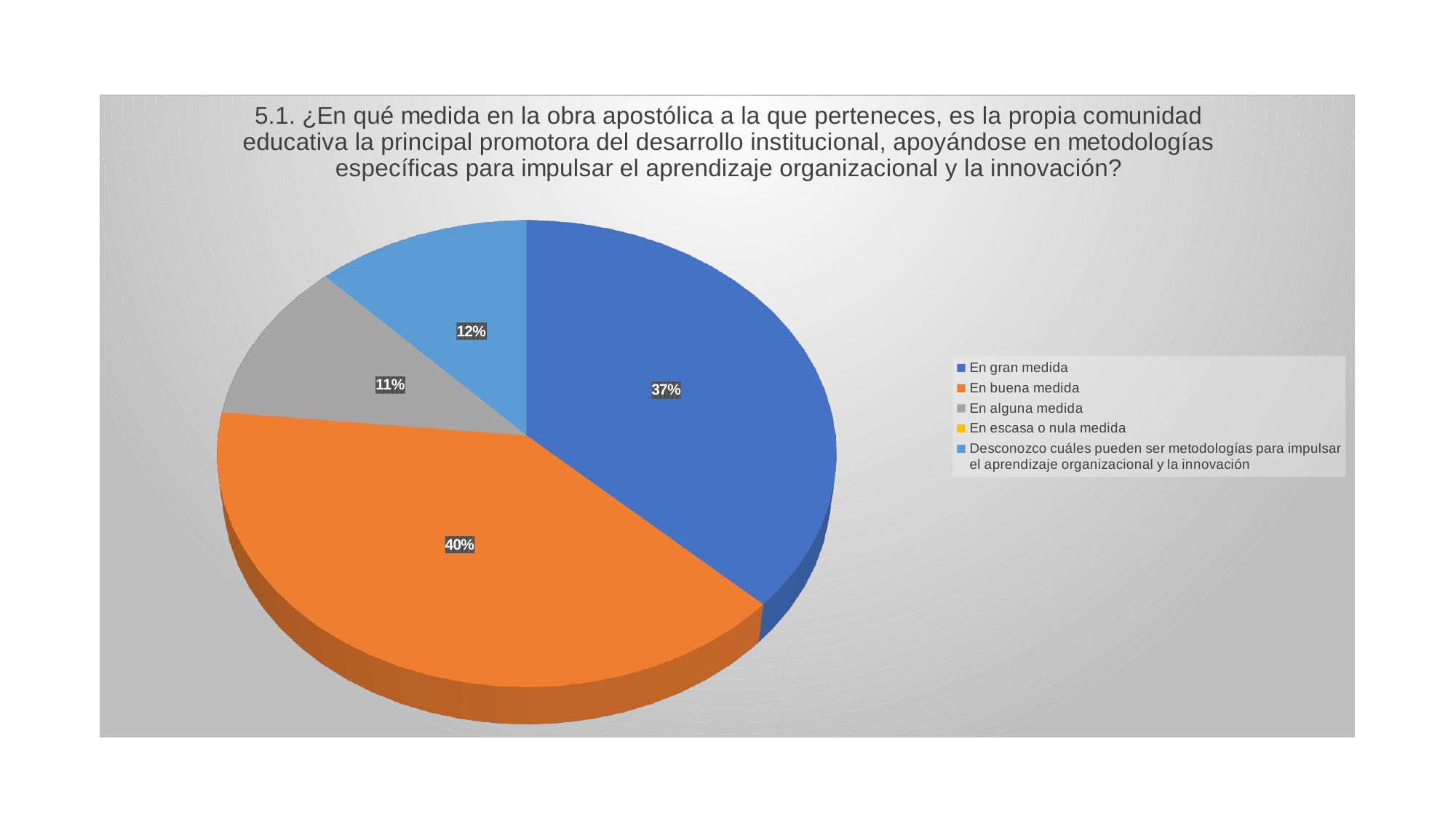
What is the value shown for "En alguna medida"? 11% How many entries does the legend list? 5 Which is larger, the slice for "En gran medida" or the slice for "En buena medida"? En buena medida What is the combined share of "En gran medida" and "En buena medida"? 77% What colour is the slice for "En buena medida"? Orange What is the difference in percentage points between the "Desconozco..." slice and the "En alguna medida" slice? 1 What percentage of the pie chart corresponds to "En gran medida"? 37% Which category has the largest slice of the pie chart? En buena medida What percentage is shown for "Desconozco cuáles pueden ser metodologías para impulsar el aprendizaje organizacional y la innovación"? 12% What type of chart is shown on the slide? Pie chart What share does "En buena medida" have in the pie chart? 40% What is the difference in percentage points between "En buena medida" and "En gran medida"? 3